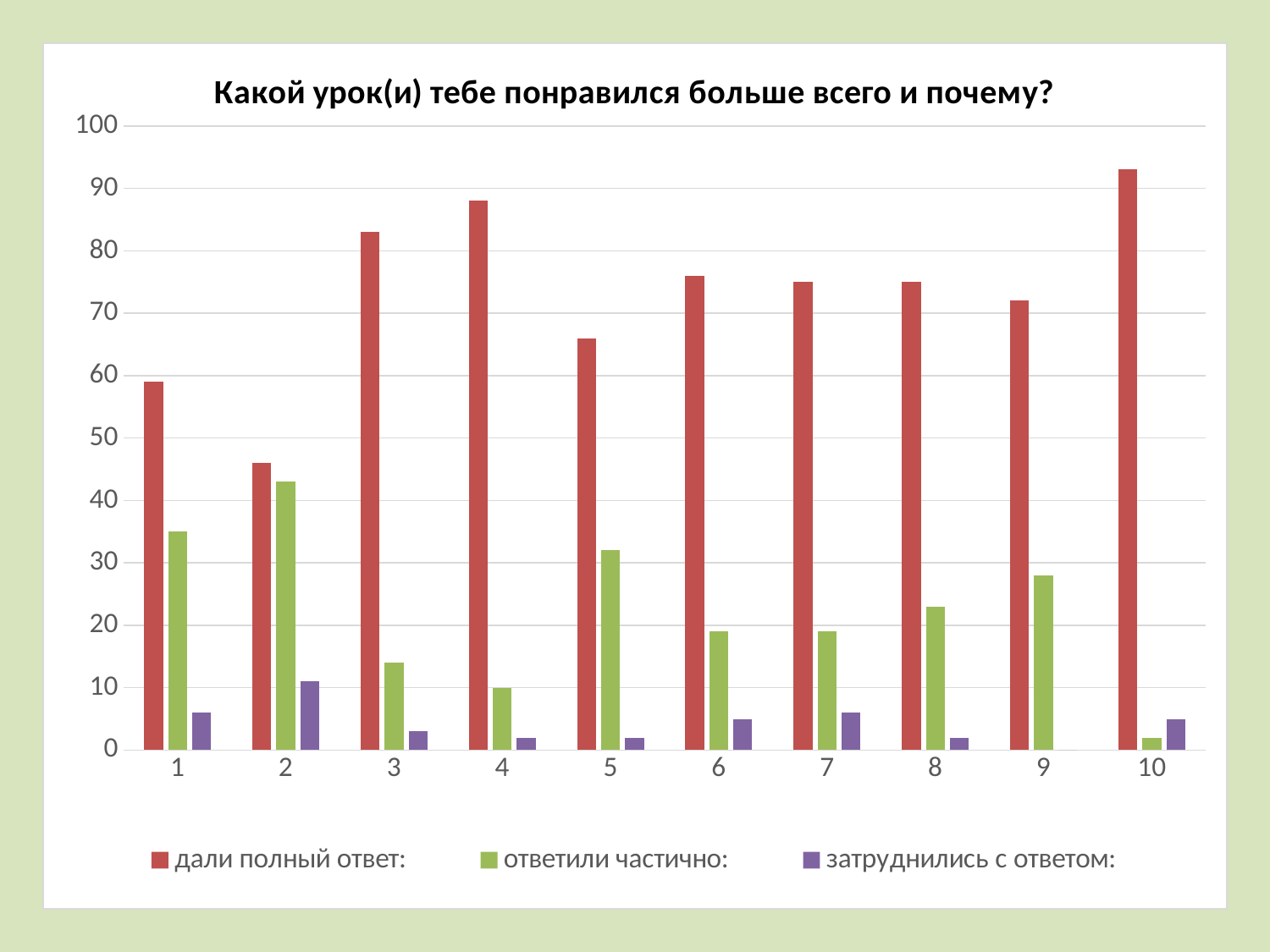
Is the value for 'дали полный ответ:' in category 5 greater or less than 70? less Which is larger: the value for 'дали полный ответ:' in category 4 or in category 3? category 4 Is the value for 'дали полный ответ:' in category 1 greater or less than 50? greater Which category has the highest value for 'ответили частично:'? 2 How many categories are shown on the x axis? 10 Which category has the highest value for 'затруднились с ответом:'? 2 Is the value for 'затруднились с ответом:' in category 2 greater or less than 20? less What is the title of the chart? Какой урок(и) тебе понравился больше всего и почему? How many series does the legend list? 3 Which category has the highest value for 'дали полный ответ:'? 10 What kind of chart is shown on the slide? bar chart Which category has the lowest value for 'дали полный ответ:'? 2